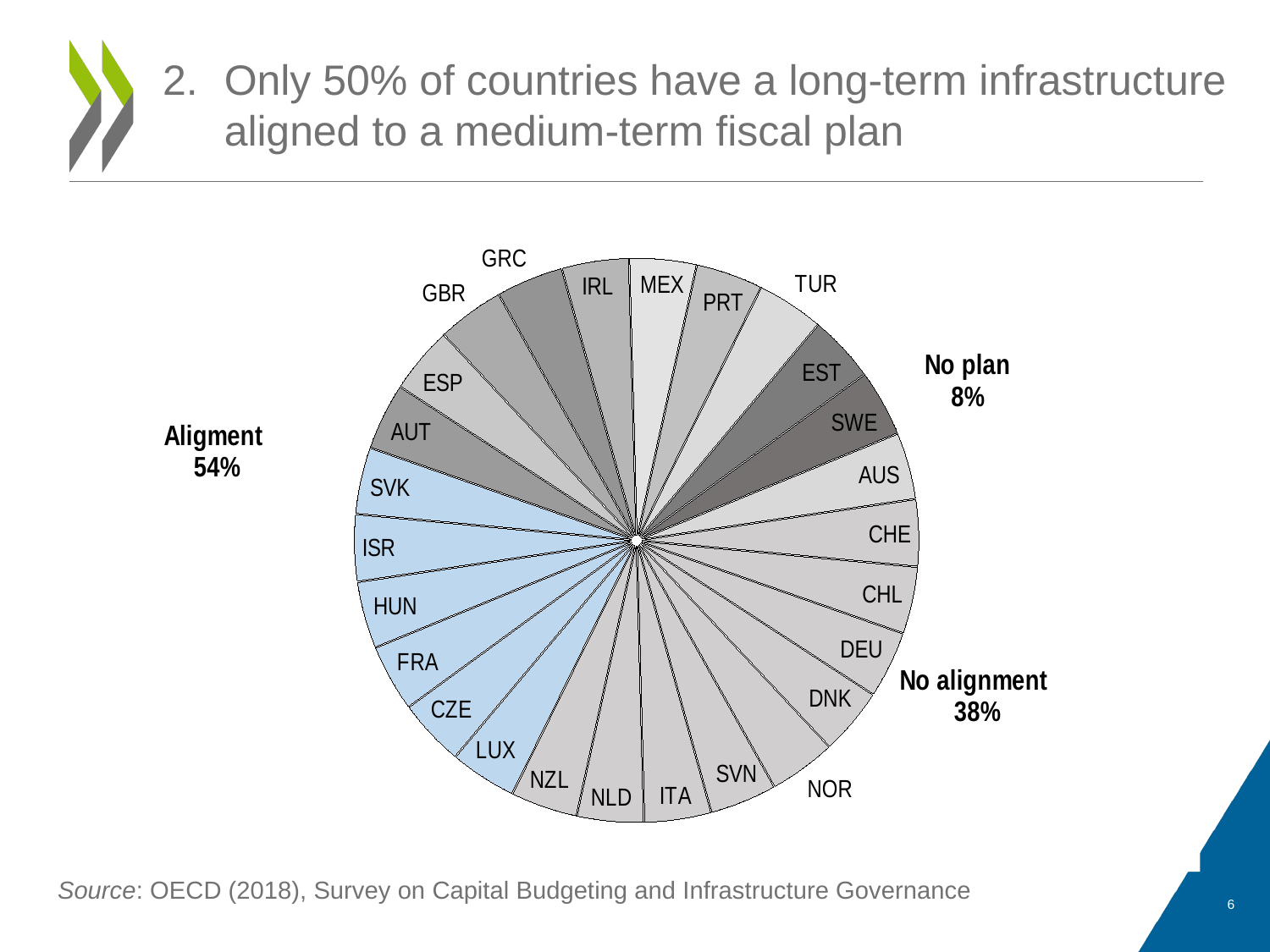
How many percentage-labelled groups are shown around the pie? 3 Which of the three labelled groups has the largest share of the pie? Aligment What is the difference in percentage points between the 'No alignment' share and the 'No plan' share? 30% What share of the pie is labelled 'Aligment'? 54% What is the difference in percentage points between the 'Aligment' share and the 'No alignment' share? 16% What is the title of the slide containing the pie chart? Only 50% of countries have a long-term infrastructure aligned to a medium-term fiscal plan Which is larger, the 'No alignment' share or the 'No plan' share? No alignment Which of the three labelled groups has the smallest share of the pie? No plan What share of the pie is labelled 'No plan'? 8% What source is cited below the pie chart? OECD (2018), Survey on Capital Budgeting and Infrastructure Governance What kind of chart is shown on the slide? pie chart What share of the pie is labelled 'No alignment'? 38%